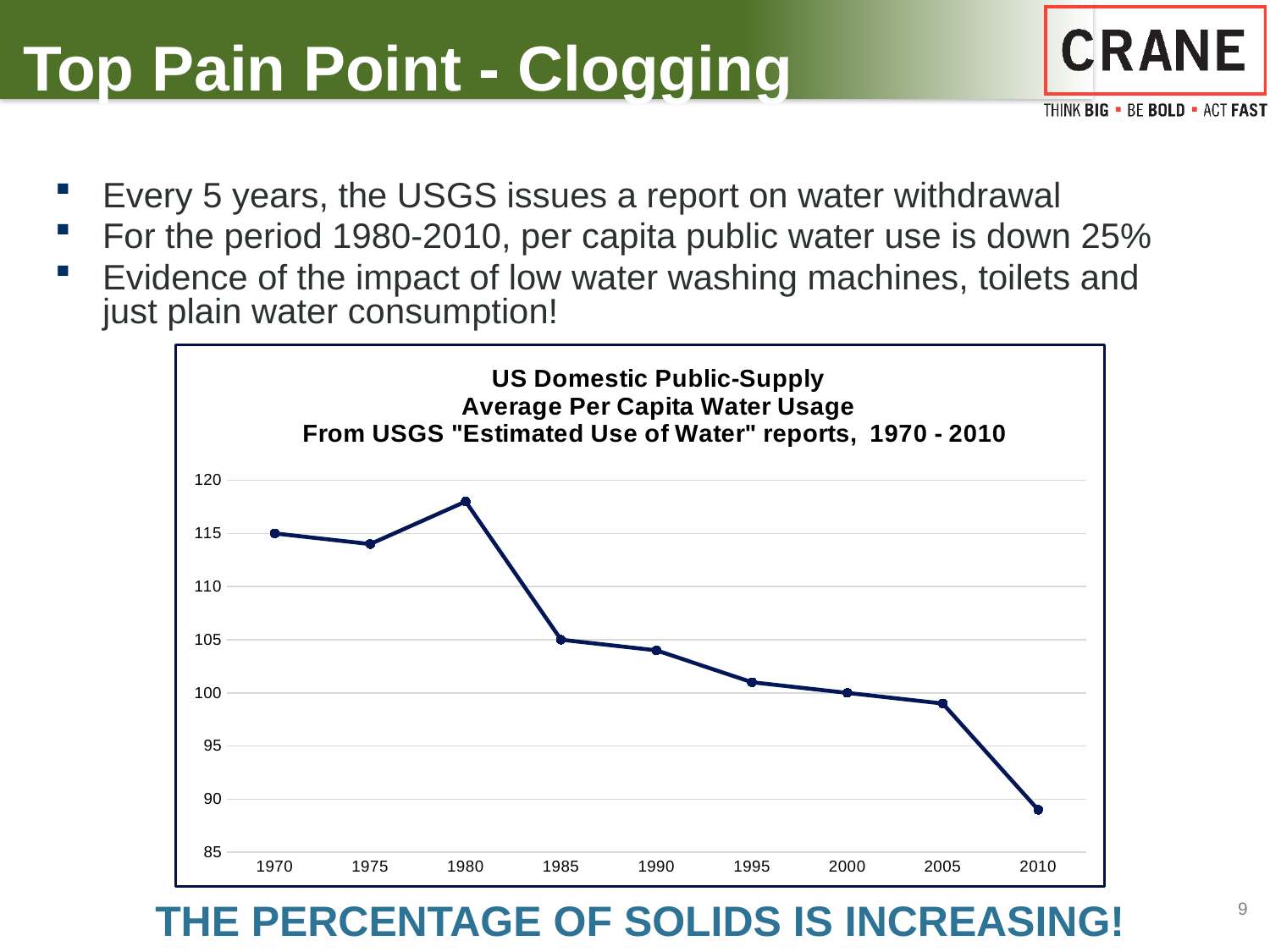
Is the value for 1980 greater or less than 115? greater Is the value for 2005 greater or less than 100? less Is the value for 2010 greater or less than 90? less What is the per capita water usage value for 1970? 115 What is the first line of the chart's title? US Domestic Public-Supply How many data points are plotted on the line? 9 What kind of chart is shown on the slide? line chart Which year has the highest per capita water usage? 1980 Overall, do the values rise or fall from 1970 to 2010? fall Which year has the lowest per capita water usage? 2010 What is the per capita water usage value for 2000? 100 Which year has the larger value, 1990 or 2000? 1990